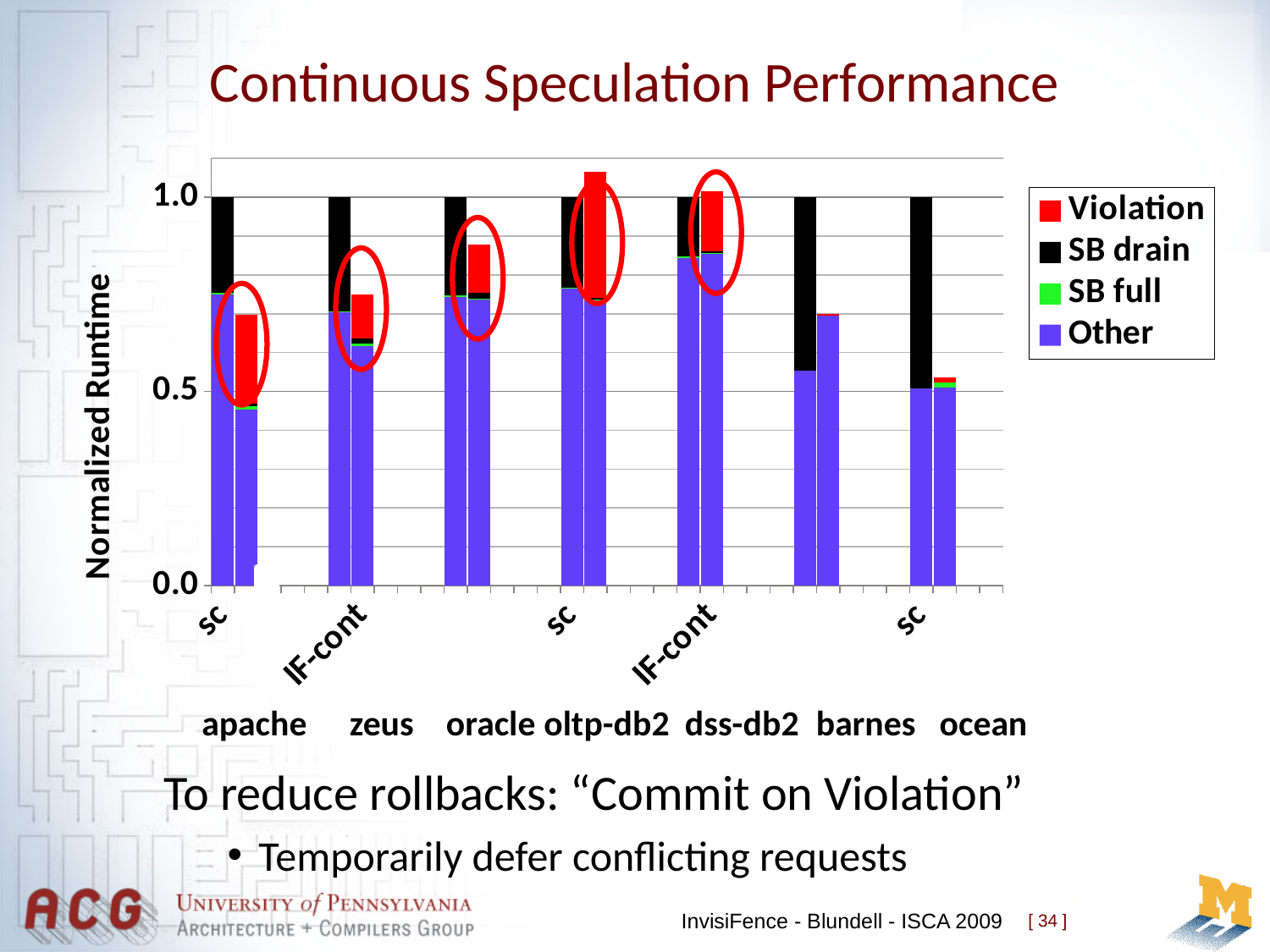
How many series does the legend list? 4 Is the IF-cont bar for oltp-db2 greater or less than 1.0? greater Is the IF-cont bar for oracle greater or less than 0.5? greater Which colour represents the Violation series in the legend? red Which benchmark has the shortest IF-cont bar? ocean For apache, which bar is taller, SC or IF-cont? SC Is the IF-cont bar for apache greater or less than 1.0? less What is the label of the y axis? Normalized Runtime How many benchmarks are labelled along the bottom of the chart? 7 What kind of chart is shown on the slide? stacked bar chart Which series forms the bottom segment of each stacked bar? Other